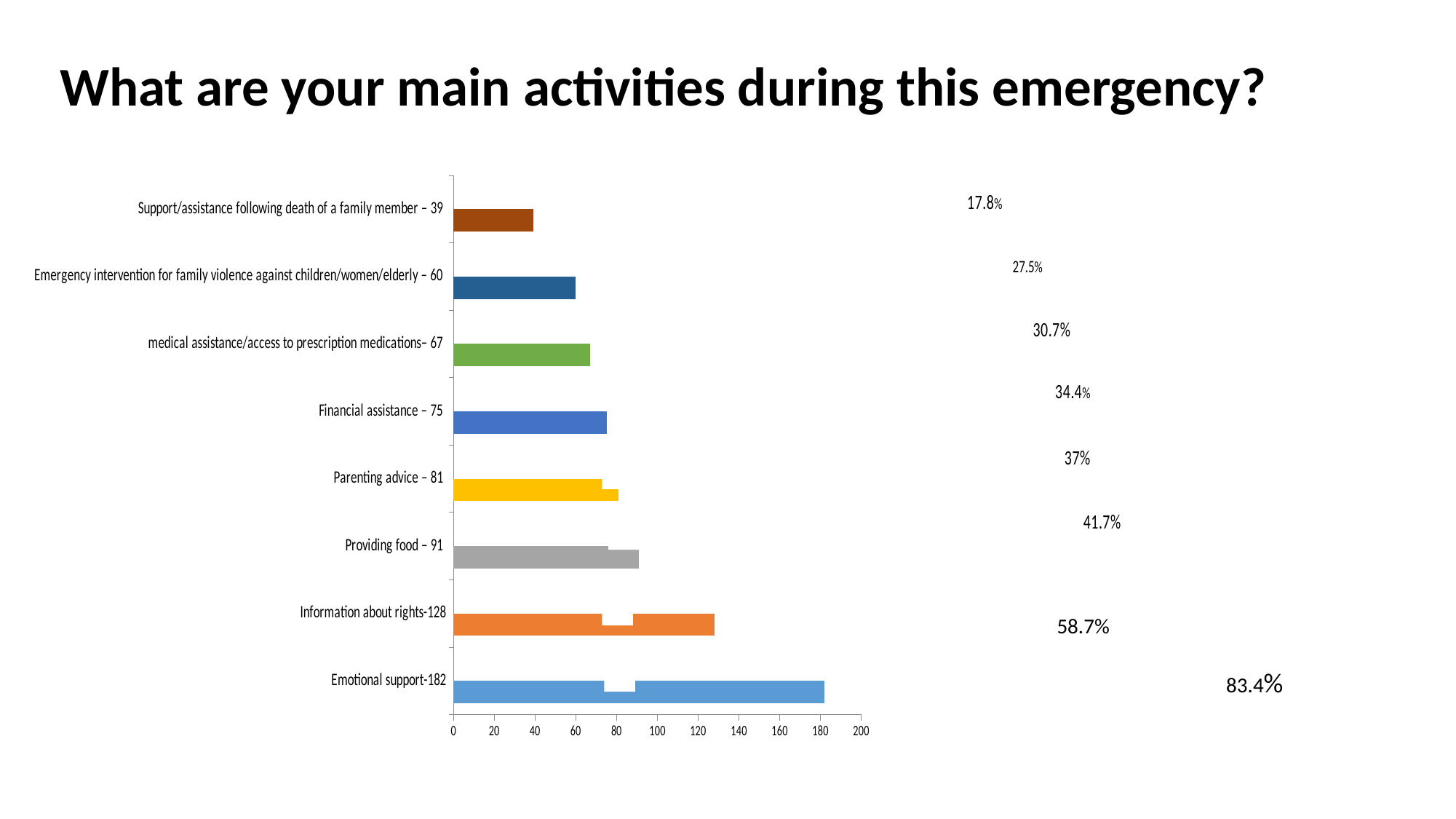
What kind of chart is shown on the slide? bar chart What is the value for Emotional support? 182 How many categories does the chart show? 8 What is the difference between the values for Emotional support and Information about rights? 54 Which category has the lowest value? Support/assistance following death of a family member What is the value for Financial assistance? 75 What is the value for Information about rights? 128 What percentage is shown next to the Emotional support bar? 83.4% What is the title of the slide? What are your main activities during this emergency? Which category has the highest value? Emotional support Is the value for Financial assistance greater or less than 100? less Which is larger, the value for Providing food or the value for Parenting advice? Providing food